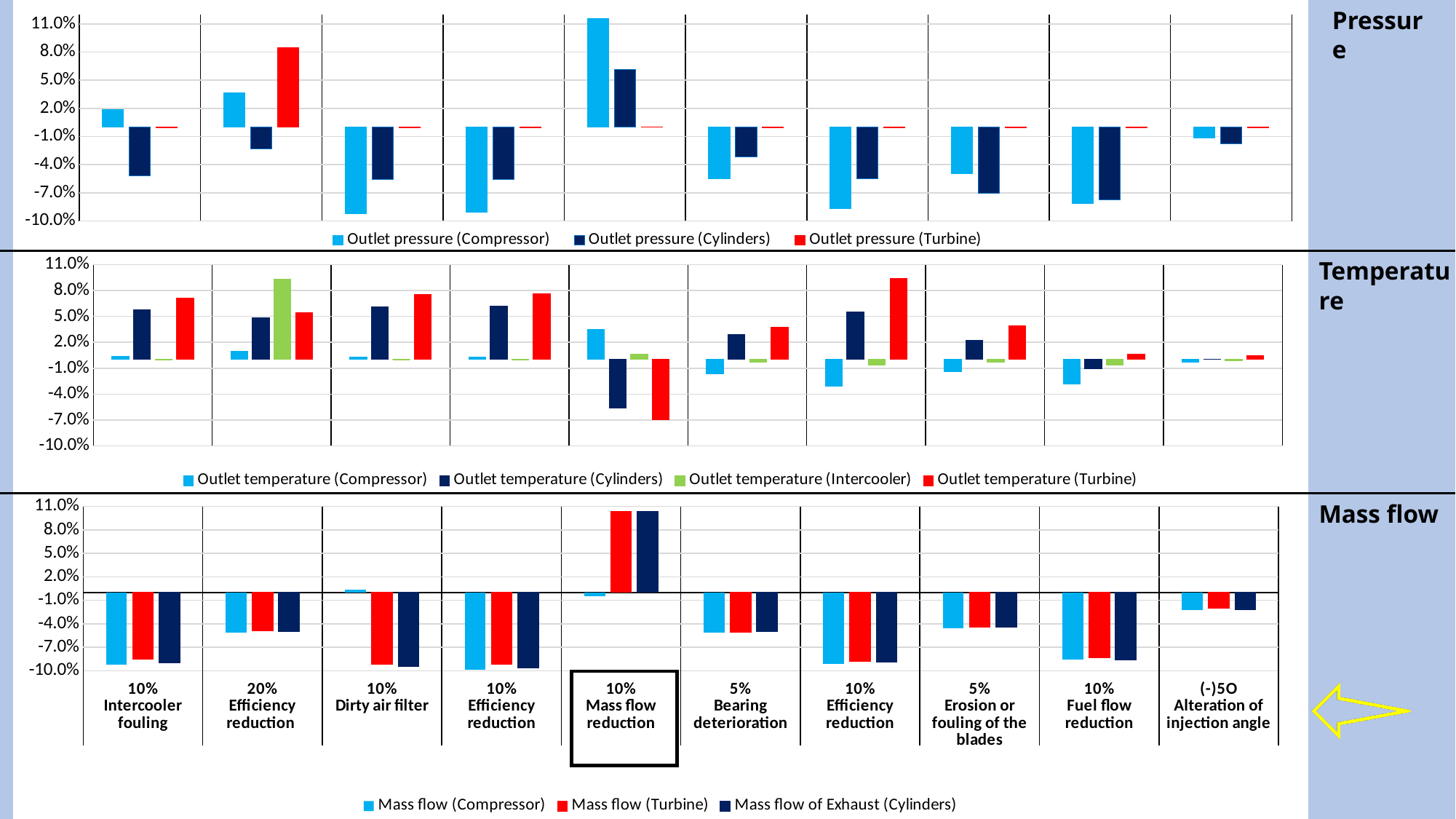
In the Mass flow chart, is the Mass flow (Turbine) value for 10% Mass flow reduction greater or less than 8.0%? greater In the Temperature chart, what colour represents Outlet temperature (Intercooler) in the legend? green How many series does the legend of the Pressure chart list? 3 How many series does the legend of the Mass flow chart list? 3 How many categories are shown along the x axis of the Mass flow chart? 10 How many series does the legend of the Temperature chart list? 4 In the Temperature chart, which category has the lowest Outlet temperature (Turbine) value? 10% Mass flow reduction In the Pressure chart, for 20% Efficiency reduction, which is larger: Outlet pressure (Turbine) or Outlet pressure (Compressor)? Outlet pressure (Turbine) In the Temperature chart, which category has the highest Outlet temperature (Intercooler) value? 20% Efficiency reduction What kind of chart is the Pressure chart at the top of the slide? bar chart In the Mass flow chart, which category has the highest Mass flow (Turbine) value? 10% Mass flow reduction In the Pressure chart, which category has the highest Outlet pressure (Compressor) value? 10% Mass flow reduction